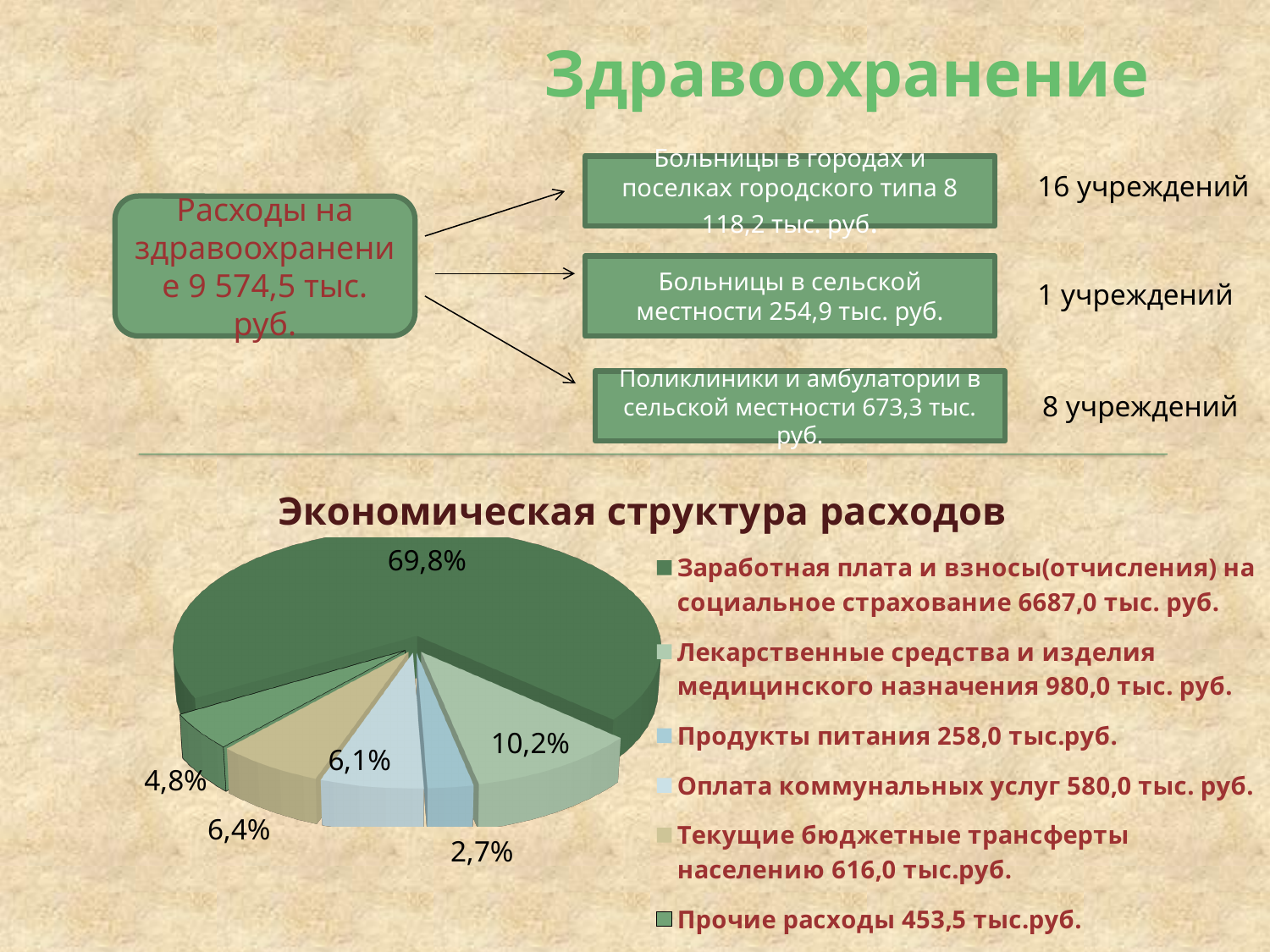
What is the title of the chart on the slide? Экономическая структура расходов Which category has the smallest slice of the pie chart? Продукты питания Which category has the largest slice of the pie chart? Заработная плата и взносы(отчисления) на социальное страхование How many entries does the legend of the pie chart list? 6 Which is larger: the slice for "Текущие бюджетные трансферты населению" or the slice for "Прочие расходы"? Текущие бюджетные трансферты населению What percentage is shown for "Продукты питания"? 2,7% What share of the pie does "Заработная плата и взносы(отчисления) на социальное страхование" take? 69,8% What is the difference in percentage points between the largest slice (69,8%) and the "Лекарственные средства" slice (10,2%)? 59,6 What percentage is shown for "Лекарственные средства и изделия медицинского назначения"? 10,2% What amount in тыс. руб. does the legend give for "Оплата коммунальных услуг"? 580,0 тыс. руб. What type of chart is shown under the heading "Экономическая структура расходов"? pie chart How many slices does the pie chart have? 6